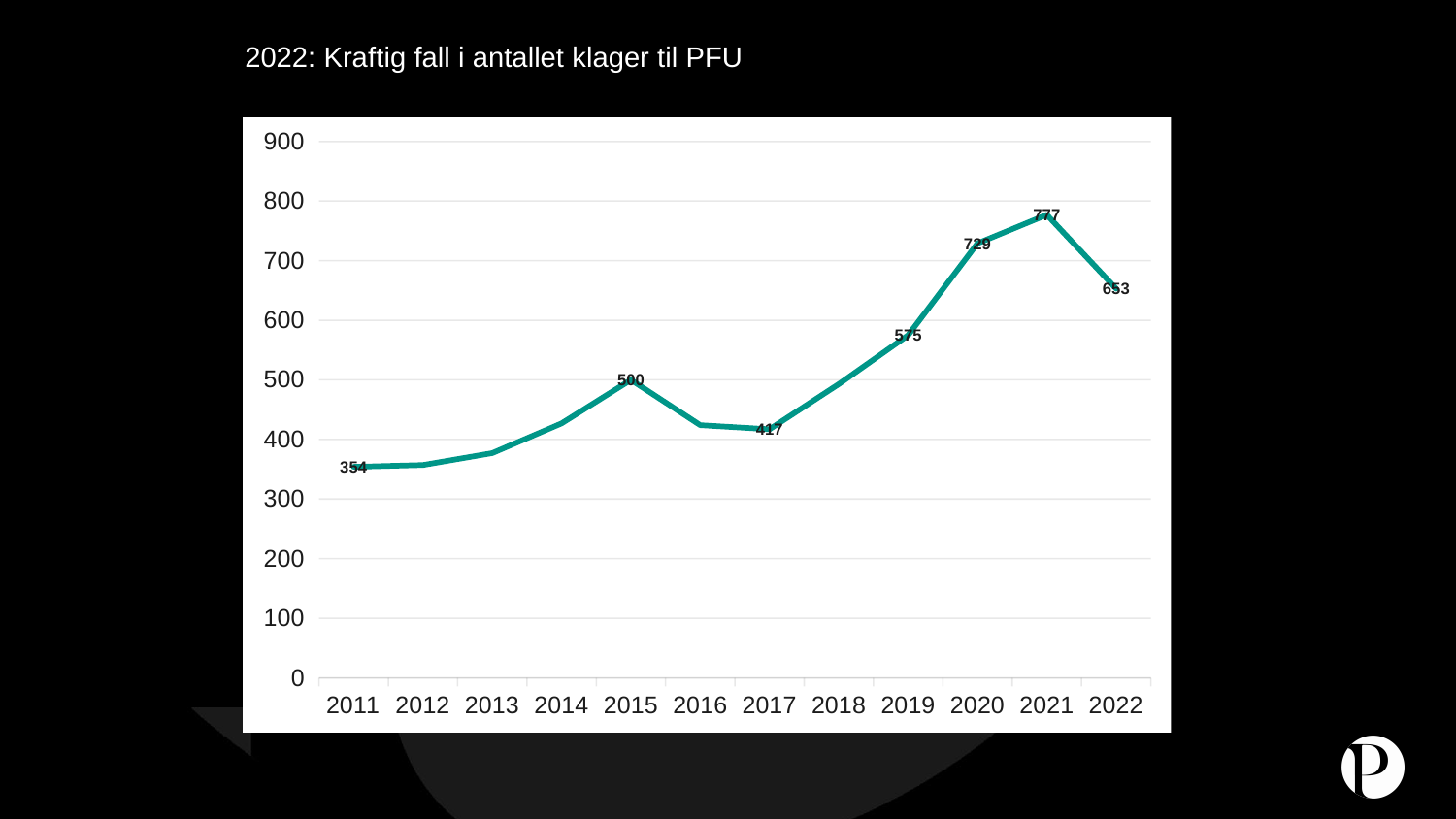
Is the value for 2013 greater or less than 400? less Which year has the highest value? 2021 What is the value for 2011? 354 What is the value for 2021? 777 What is the difference between the values for 2021 and 2022? 124 Do the values rise or fall from 2017 to 2021? rise What is the value for 2022? 653 Which year has the lowest value? 2011 Which is larger, the value for 2015 or the value for 2017? 2015 How many years are shown on the x axis? 12 What is the value for 2019? 575 What kind of chart is this? line chart